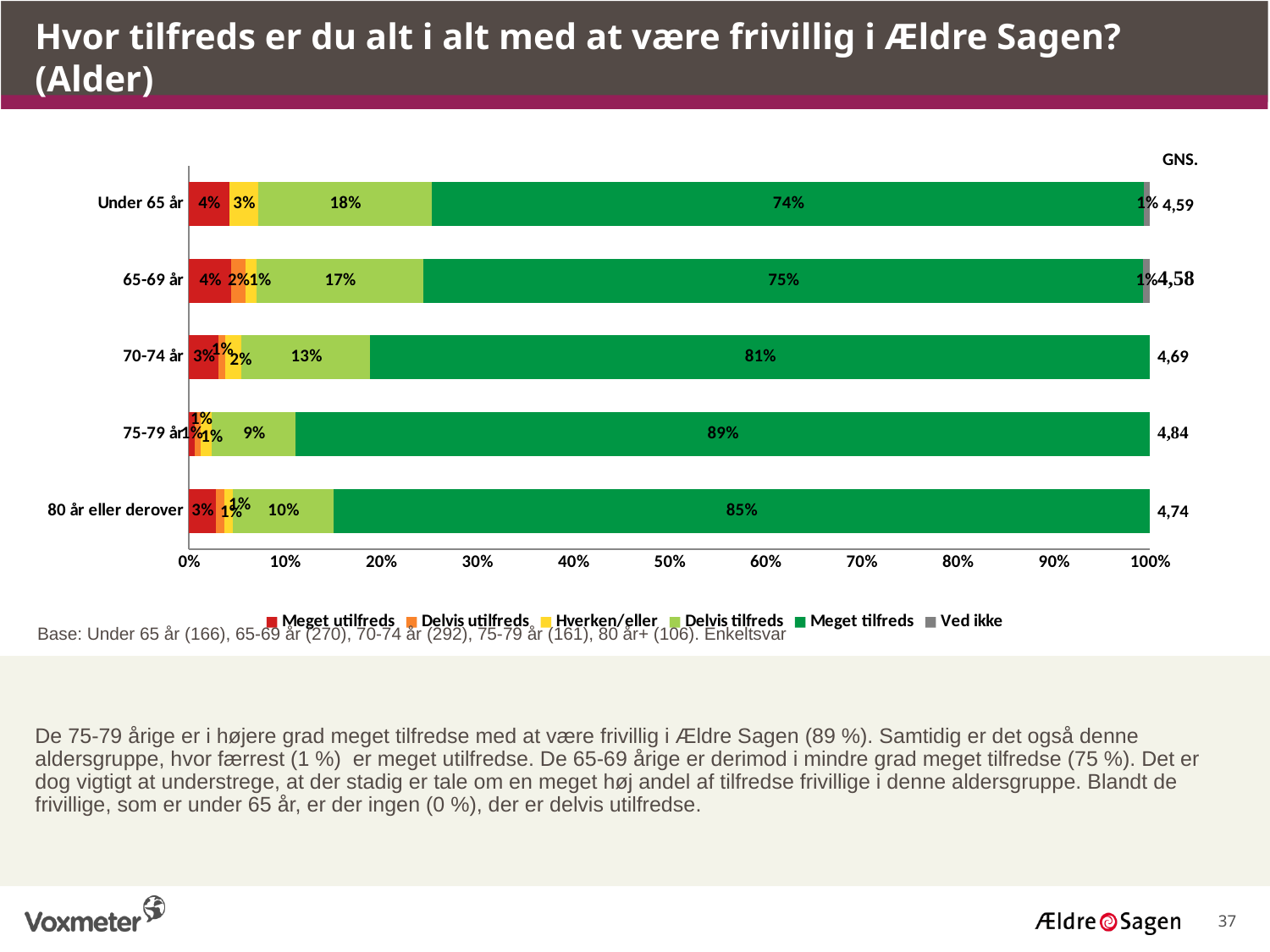
How many age categories are shown on the chart? 5 Which colour represents 'Meget tilfreds' in the legend? Dark green What is the difference between the 'Meget tilfreds' values for 75-79 år and 65-69 år? 14 percentage points How many series does the legend list? 6 What is the 'Meget tilfreds' value for 75-79 år? 89% Which age group has the lowest 'Meget tilfreds' share? Under 65 år What is the GNS. value shown for 70-74 år? 4,69 What is the 'Delvis tilfreds' value for Under 65 år? 18% What kind of chart is shown on the slide? Stacked bar chart Which is larger, the 'Delvis tilfreds' value for 65-69 år or for 80 år eller derover? 65-69 år Is the 'Meget tilfreds' value for 70-74 år greater or less than 80%? greater Which age group has the highest 'Meget tilfreds' share? 75-79 år